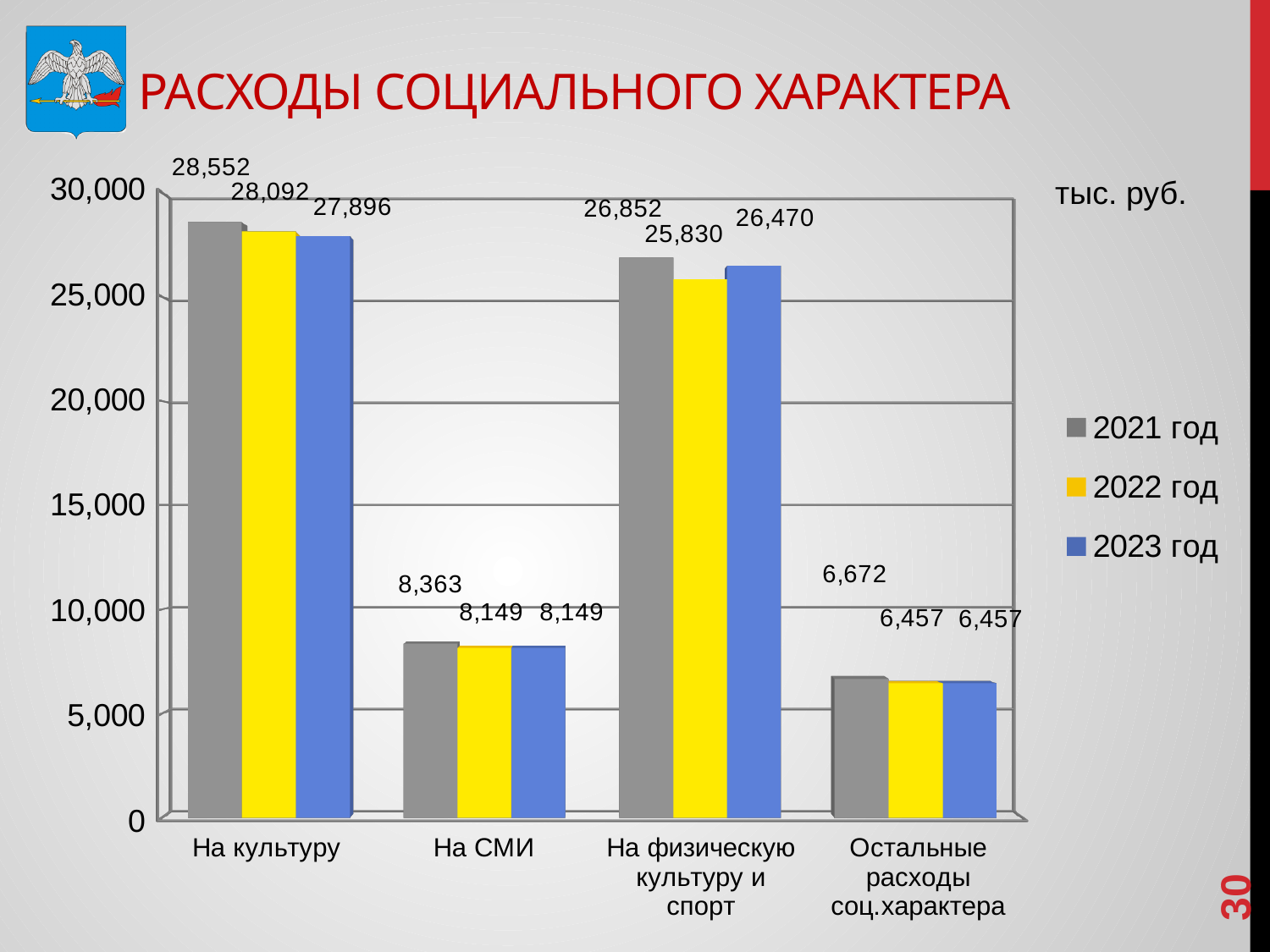
What is the value for 2021 год in the category На культуру? 28,552 Which is larger for На физическую культуру и спорт: the 2022 год value or the 2023 год value? 2023 год What unit is indicated next to the chart? тыс. руб. Which category has the lowest value for 2021 год? Остальные расходы соц.характера What is the value for 2021 год in the category Остальные расходы соц.характера? 6,672 What is the value for 2023 год in the category На СМИ? 8,149 What is the value for 2022 год in the category На физическую культуру и спорт? 25,830 How many categories are shown on the x axis? 4 What kind of chart is shown on the slide? Bar chart Which category has the highest value for 2023 год? На культуру How many series does the legend list? 3 What is the difference between the 2021 год and 2023 год values for На культуру? 656